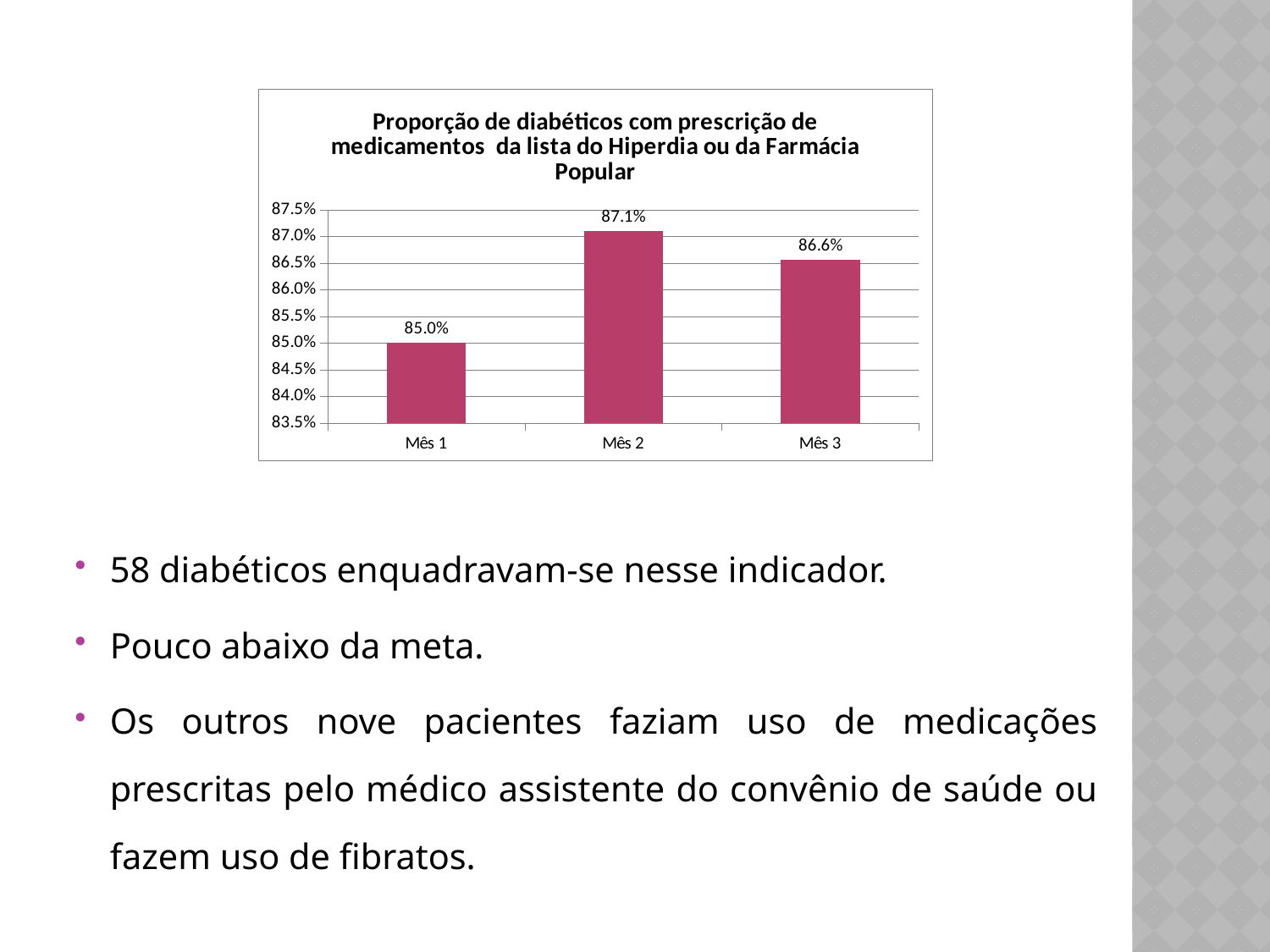
Is the value for Mês 3 greater or less than 86.0%? greater What is the value for Mês 2? 87.1% What is the value for Mês 3? 86.6% What kind of chart is shown on the slide? Bar chart Which month has the highest value? Mês 2 What is the difference between the values for Mês 2 and Mês 3? 0.5% Which month has the lowest value? Mês 1 What is the value for Mês 1? 85.0% Which is larger, the value for Mês 3 or the value for Mês 1? Mês 3 What is the title of the chart? Proporção de diabéticos com prescrição de medicamentos da lista do Hiperdia ou da Farmácia Popular What is the difference between the values for Mês 2 and Mês 1? 2.1% How many months are shown on the x axis? 3